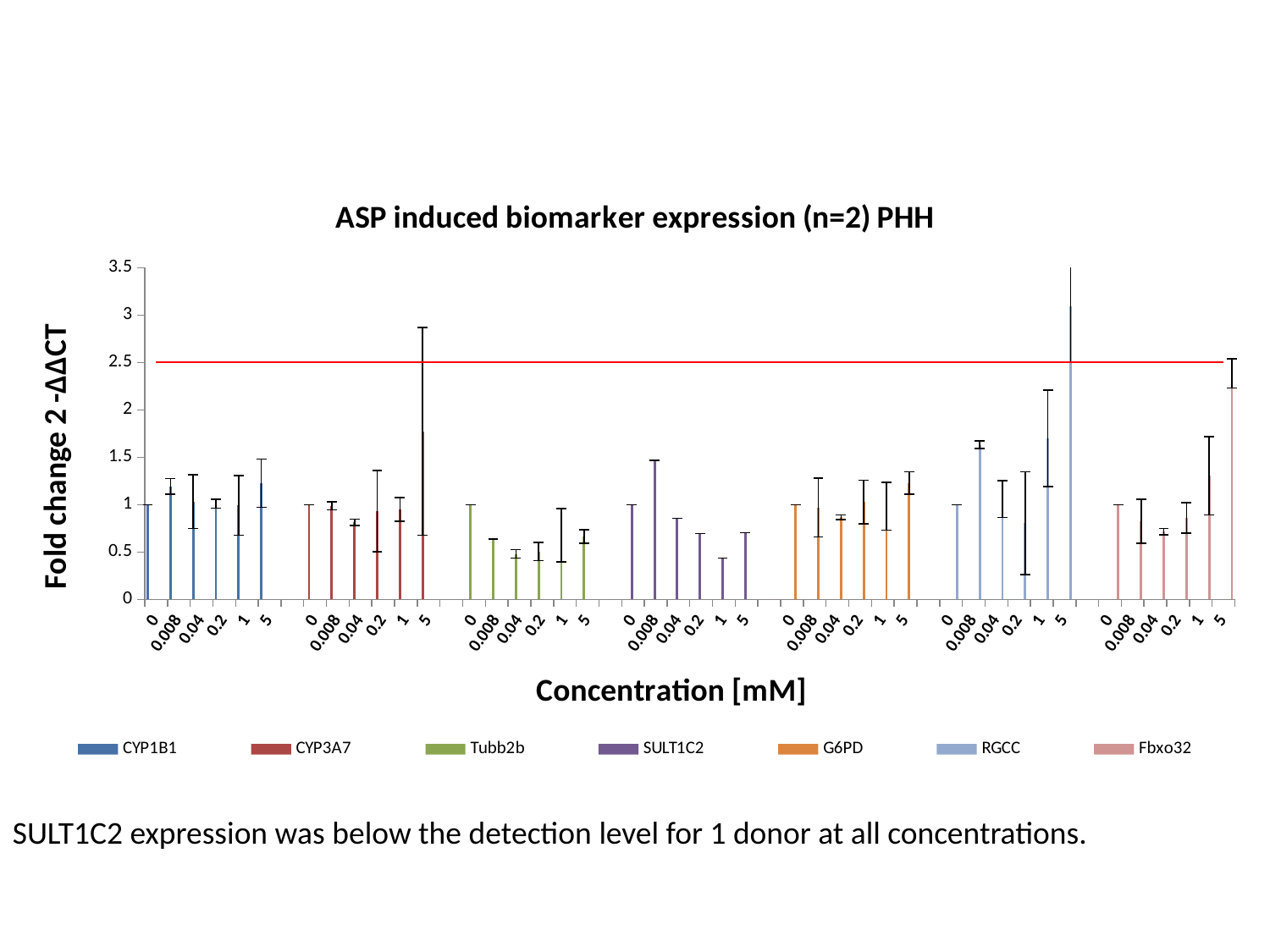
Which is larger for Fbxo32: the value at concentration 5 or the value at concentration 0.04? 5 Is the value for SULT1C2 at concentration 1 greater or less than 0.5? less Is the value for Fbxo32 at concentration 5 greater or less than 2? greater What kind of chart is shown on the slide? bar chart Is the value for SULT1C2 at concentration 0.008 greater or less than 1? greater Which is larger for SULT1C2: the value at concentration 0.008 or the value at concentration 1? 0.008 What is the label of the x axis? Concentration [mM] What is the title of the chart? ASP induced biomarker expression (n=2) PHH How many series does the legend list? 7 How many concentration levels are plotted for each biomarker series? 6